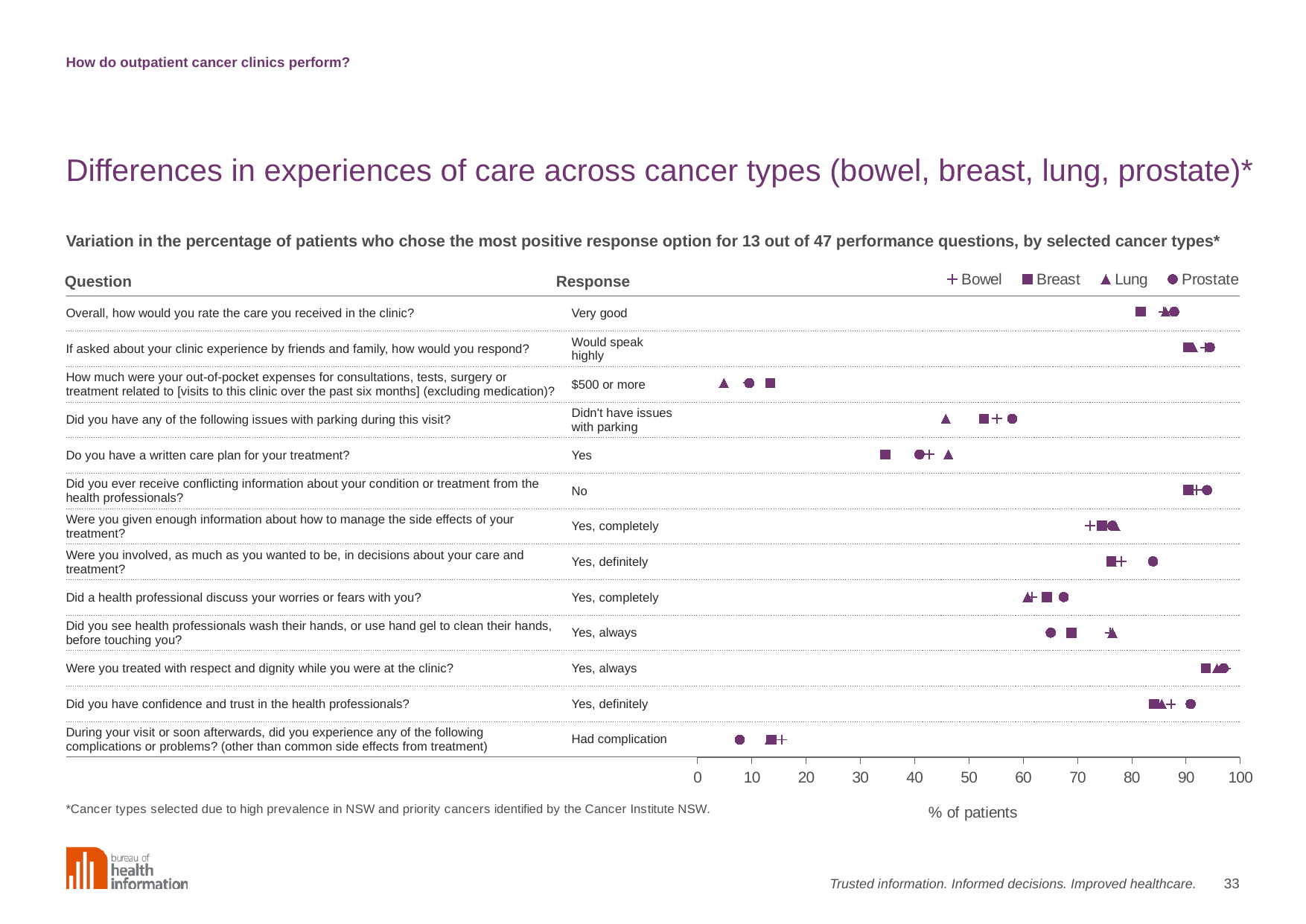
Is the Prostate value for seeing health professionals wash their hands ('Yes, always') greater or less than 70? less Is the Breast value for having a written care plan ('Yes') greater or less than 40? less Is the Prostate value for being involved in decisions ('Yes, definitely') greater or less than 80? greater For 'Didn't have issues with parking', which is larger: the Lung value or the Prostate value? Prostate How many cancer types does the legend list? 4 What is the label on the horizontal axis? % of patients How many performance questions are plotted on the chart? 13 What kind of chart is used to show the variation across cancer types? Dot plot For having a written care plan ('Yes'), which is larger: the Breast value or the Lung value? Lung Which marker symbol represents Bowel cancer in the legend? Plus sign For which response does Lung have its lowest value on the chart? $500 or more